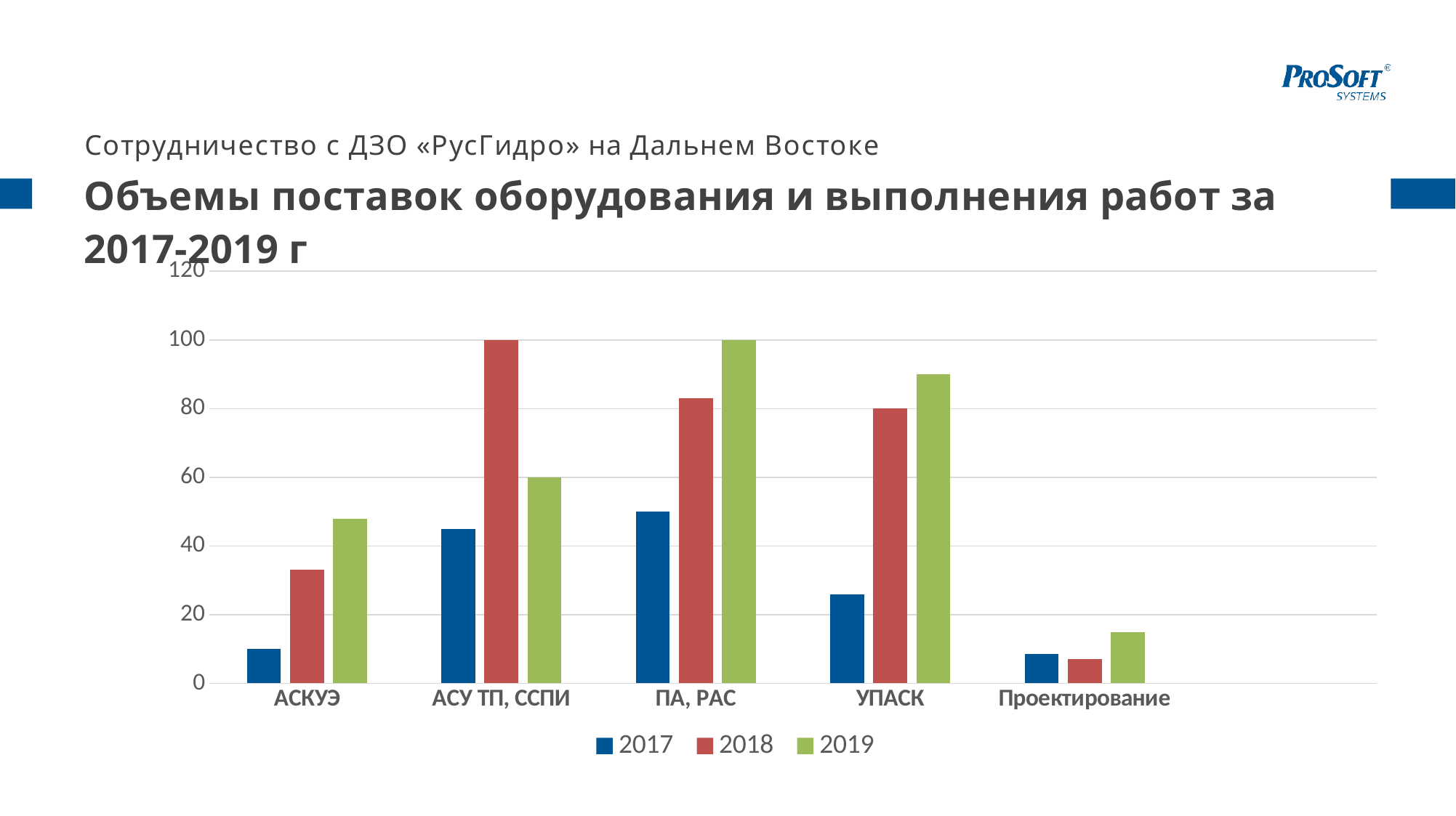
What is the value for ПА, РАС in 2019? 100 Which category has the lowest value for 2018? Проектирование What is the value for АСУ ТП, ССПИ in 2018? 100 What is the value for УПАСК in 2018? 80 For АСУ ТП, ССПИ, which is larger: the 2018 value or the 2019 value? 2018 Which category has the highest value for 2018? АСУ ТП, ССПИ Is the value for АСКУЭ in 2017 greater or less than 20? less How many series does the legend list? 3 Do the values for АСКУЭ rise or fall from 2017 to 2019? rise Is the value for УПАСК in 2019 greater or less than 80? greater How many categories are shown on the x axis? 5 What kind of chart is shown on the slide? bar chart